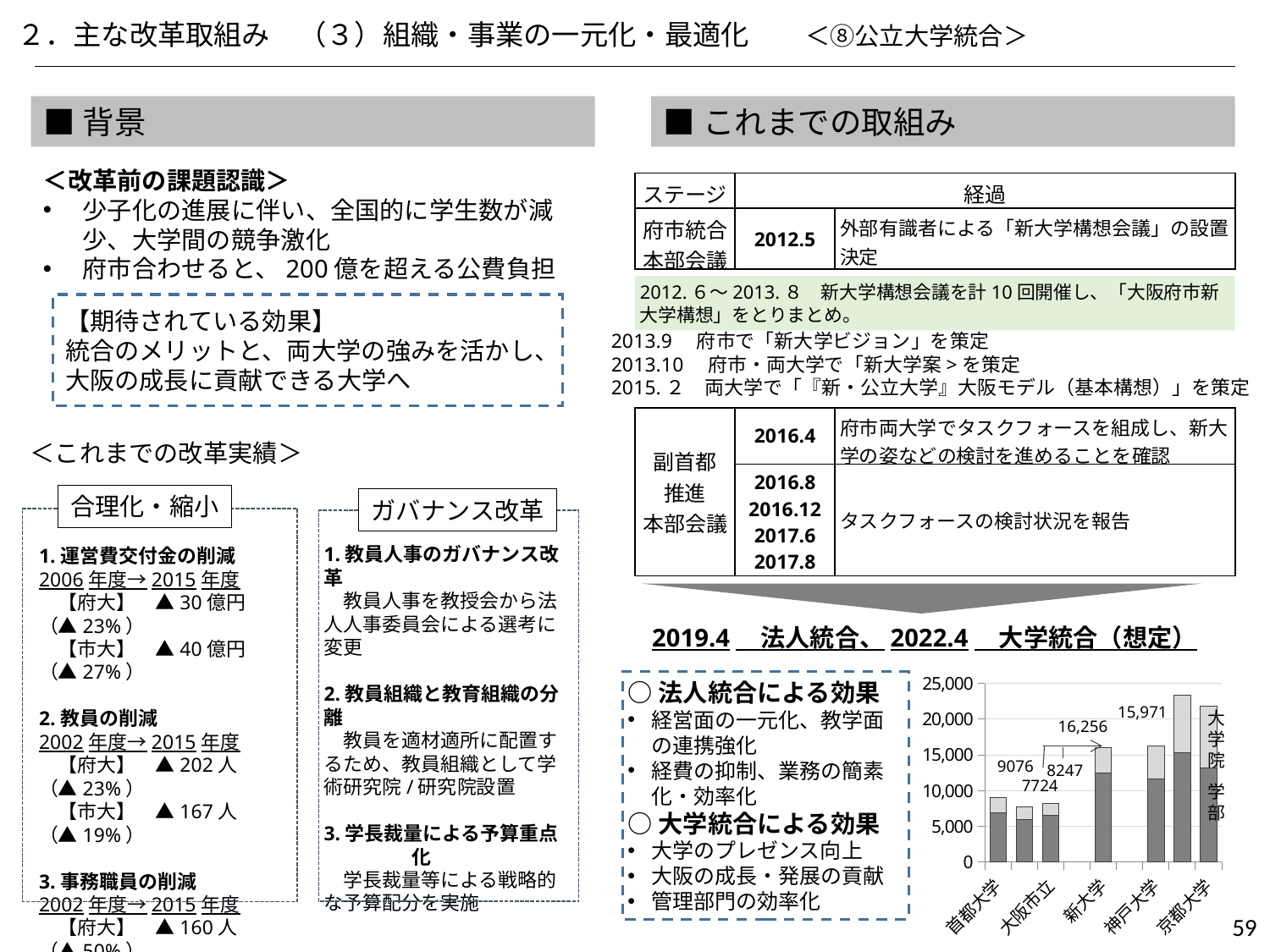
What kind of chart is shown at the bottom right of the slide? stacked bar chart In the bar chart at the bottom right, which is larger, the value for 首都大学 or the value for 新大学? 新大学 How many series does the bar chart at the bottom right show? 2 What are the two series shown in the bar chart at the bottom right? 大学院 and 学部 In the bar chart at the bottom right, is the value for 首都大学 greater or less than 10,000? less What is the highest value shown on the vertical axis of the bar chart at the bottom right? 25,000 In the bar chart at the bottom right, is the value for 大阪市立 greater or less than 10,000? less In the bar chart at the bottom right, is the value for 新大学 greater or less than 15,000? greater In the bar chart at the bottom right, what is the value labelled for 首都大学? 9076